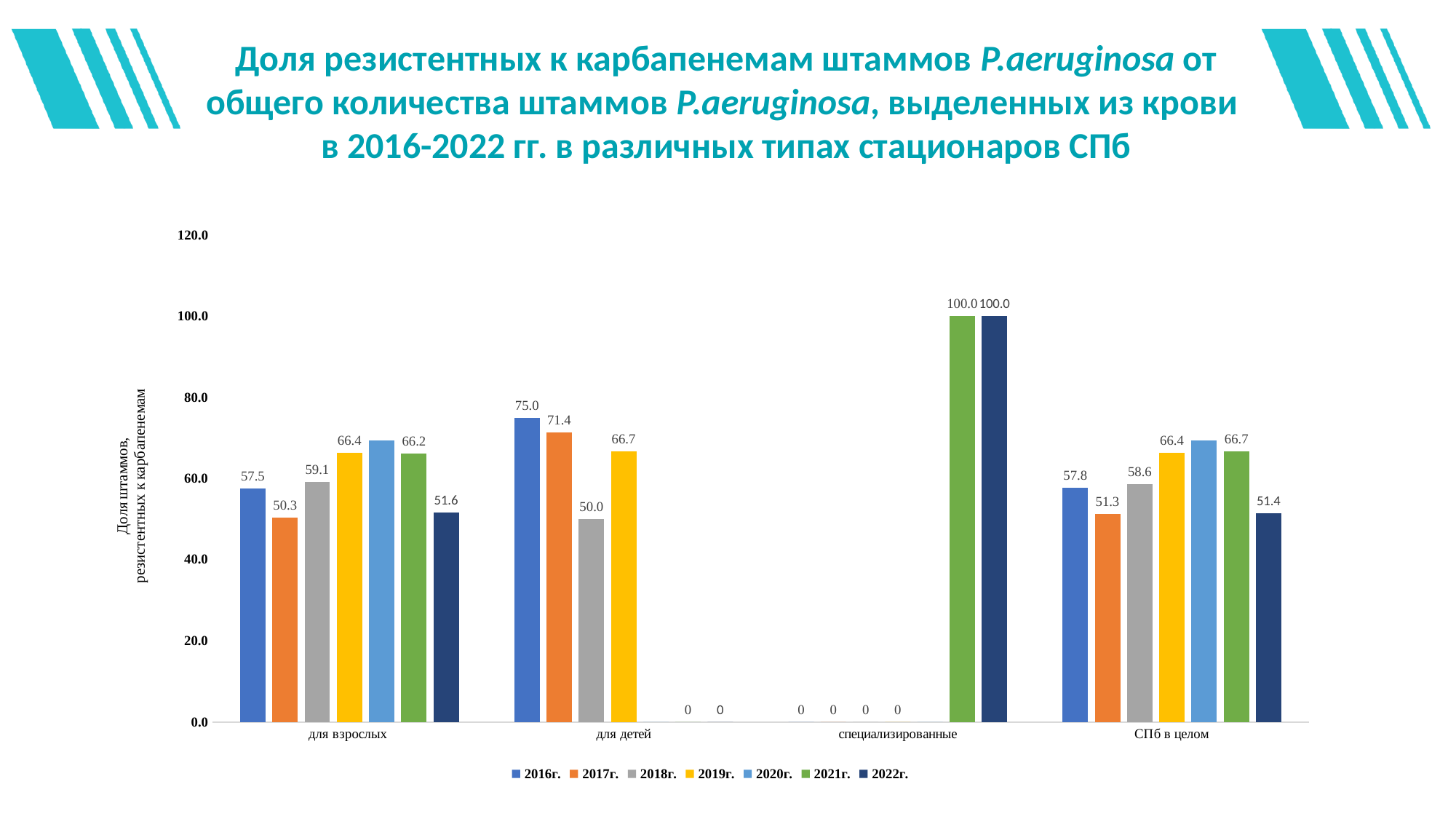
What kind of chart is shown on the slide? bar chart What is the value for 2021г. in the "специализированные" category? 100.0 What is the value for 2016г. in the "для взрослых" category? 57.5 What is the value for 2019г. in the "для детей" category? 66.7 For 2017г., which category has the larger value: "для взрослых" or "для детей"? для детей Is the value for 2020г. in the "для взрослых" category greater or less than 60.0? greater Which year has the lowest value in the "для взрослых" category? 2017г. Which year has the highest value in the "для детей" category? 2016г. What is the value for 2022г. in the "СПб в целом" category? 51.4 How many series does the legend list? 7 How many categories are shown on the x axis? 4 What is the difference between the 2016г. and 2018г. values in the "для детей" category? 25.0